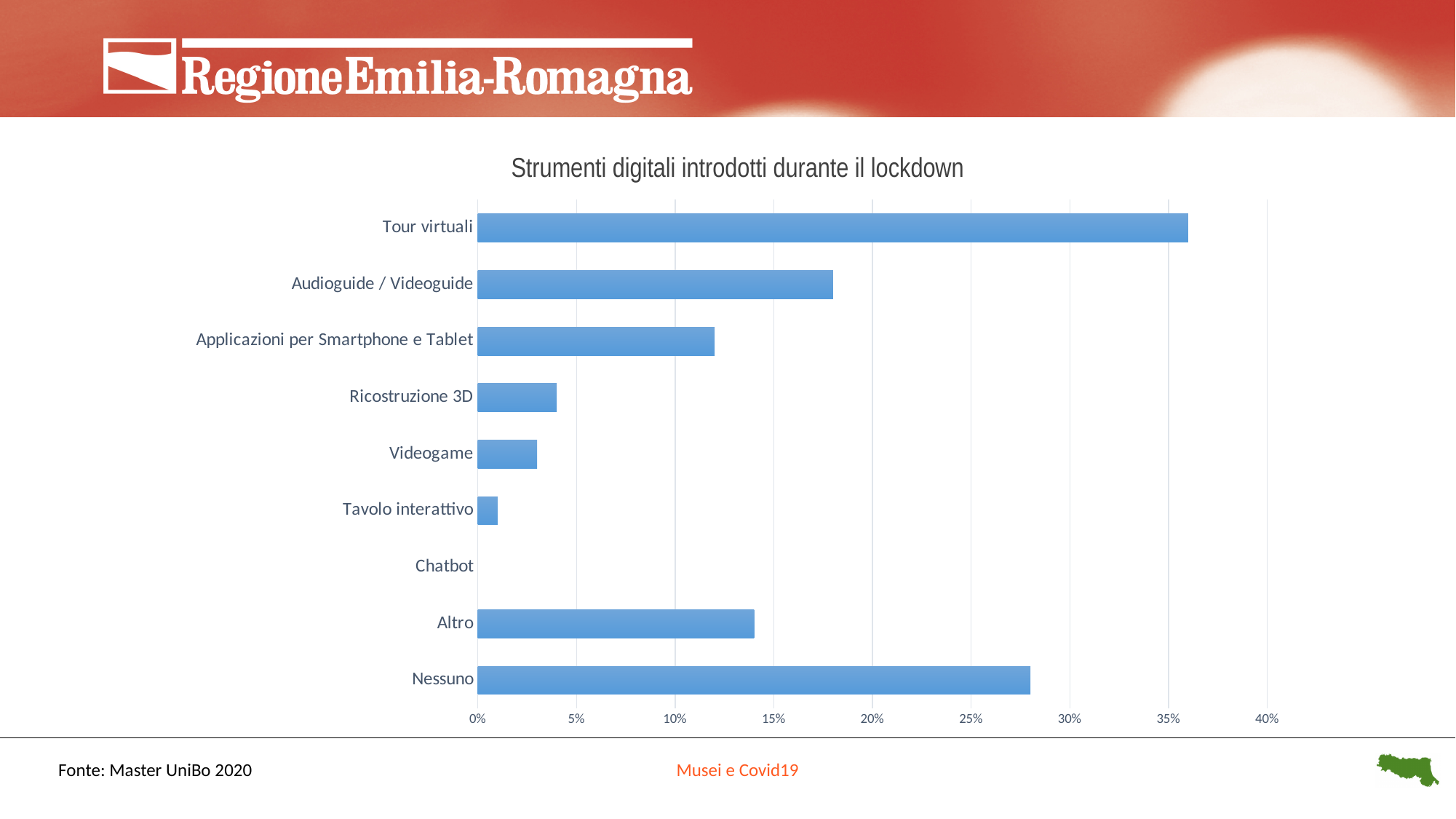
Which category has the lowest value? Chatbot What is the title of the chart? Strumenti digitali introdotti durante il lockdown Which is larger, the value for Altro or the value for Applicazioni per Smartphone e Tablet? Altro Is the value for Ricostruzione 3D greater or less than 5%? less Which category has the highest value? Tour virtuali Is the value for Nessuno greater or less than 25%? greater Is the value for Applicazioni per Smartphone e Tablet greater or less than 10%? greater How many categories are shown on the chart? 9 Which is larger, the value for Nessuno or the value for Audioguide / Videoguide? Nessuno What kind of chart is shown on the slide? bar chart